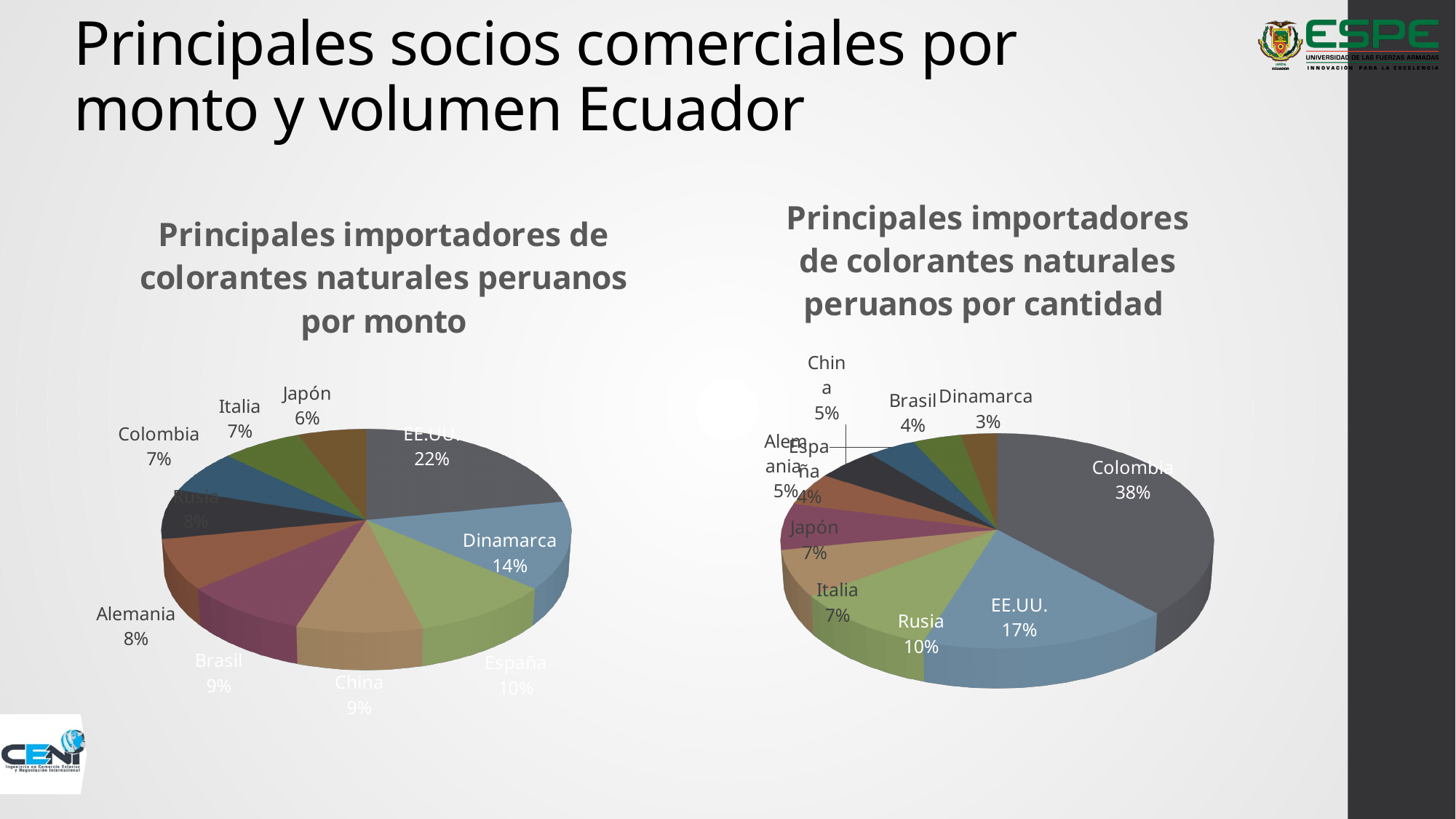
In the chart 'Principales importadores de colorantes naturales peruanos por monto', what share does EE.UU. have? 22% In the chart 'Principales importadores de colorantes naturales peruanos por cantidad', which country has the largest share? Colombia In the chart 'Principales importadores de colorantes naturales peruanos por monto', what share does Dinamarca have? 14% In the chart 'Principales importadores de colorantes naturales peruanos por cantidad', what share does Colombia have? 38% What type of chart is used for 'Principales importadores de colorantes naturales peruanos por cantidad'? Pie chart In the chart 'Principales importadores de colorantes naturales peruanos por monto', what is the difference between the shares of EE.UU. and Dinamarca? 8 percentage points In the chart 'Principales importadores de colorantes naturales peruanos por cantidad', which is larger, the share of EE.UU. or the share of Rusia? EE.UU. In the chart 'Principales importadores de colorantes naturales peruanos por monto', which country has the smallest share? Japón In the chart 'Principales importadores de colorantes naturales peruanos por cantidad', which country has the smallest share? Dinamarca In the chart 'Principales importadores de colorantes naturales peruanos por monto', how many countries are shown? 10 In the chart 'Principales importadores de colorantes naturales peruanos por monto', which country has the largest share? EE.UU. In the chart 'Principales importadores de colorantes naturales peruanos por cantidad', what share does Rusia have? 10%